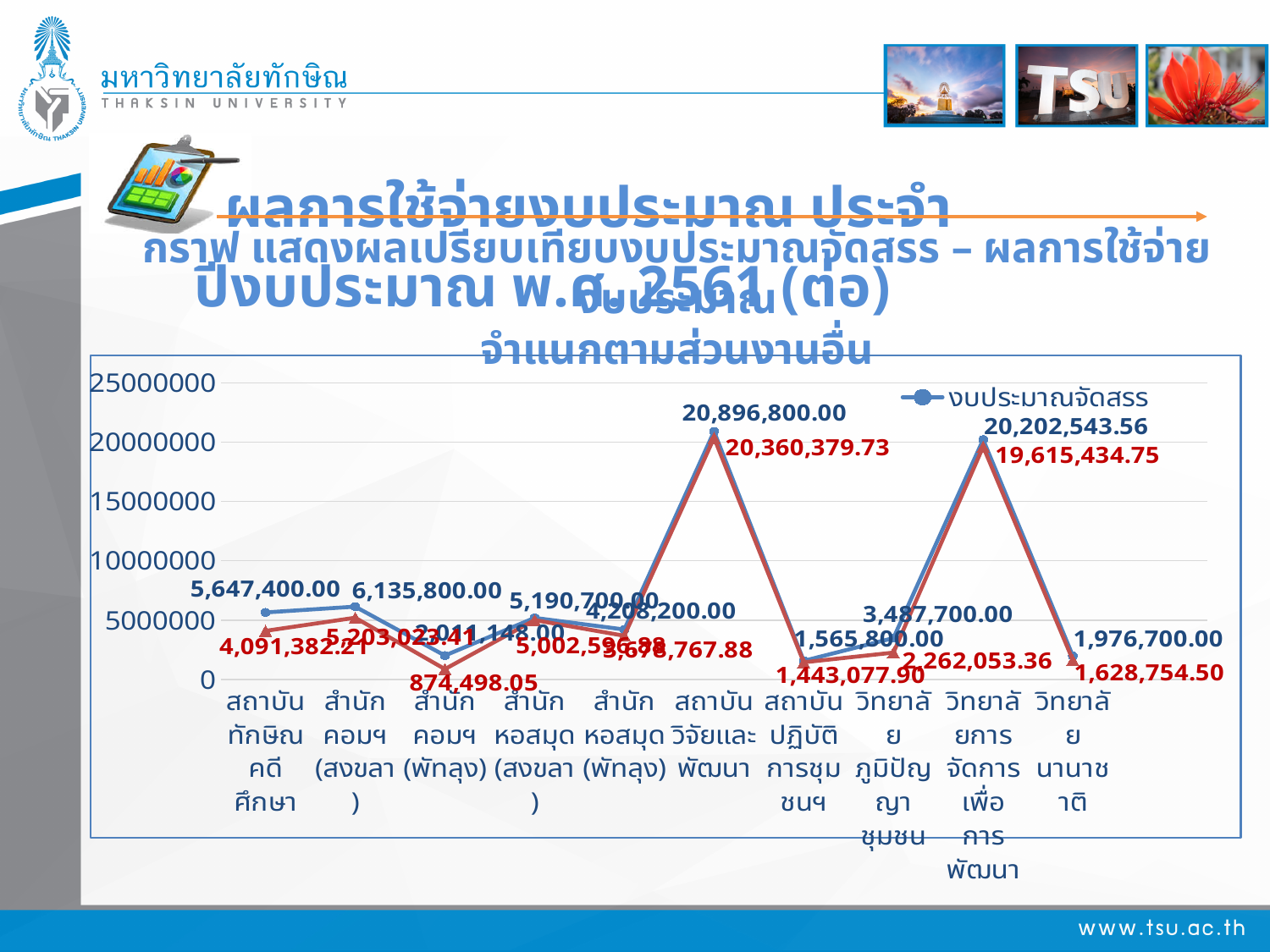
What is the difference between the two values shown for วิทยาลัยการจัดการเพื่อการพัฒนา (20,202,543.56 and 19,615,434.75)? 587,108.81 Which has the larger งบประมาณจัดสรร value: สำนักคอมฯ (สงขลา) or สถาบันทักษิณคดีศึกษา? สำนักคอมฯ (สงขลา) What is the difference between the two values shown for สถาบันวิจัยและพัฒนา (20,896,800.00 and 20,360,379.73)? 536,420.27 What series name is shown in the chart legend? งบประมาณจัดสรร What kind of chart is shown on the slide? line chart Which unit has the highest งบประมาณจัดสรร value? สถาบันวิจัยและพัฒนา Is the งบประมาณจัดสรร value for สถาบันวิจัยและพัฒนา greater or less than 20000000? greater What is the งบประมาณจัดสรร value for วิทยาลัยนานาชาติ? 1,976,700.00 Which unit has the lowest red-series value? สำนักคอมฯ (พัทลุง) How many units (categories) are shown on the x axis of the chart? 10 What is the งบประมาณจัดสรร value for สถาบันวิจัยและพัฒนา? 20,896,800.00 What is the red-series value for วิทยาลัยการจัดการเพื่อการพัฒนา? 19,615,434.75